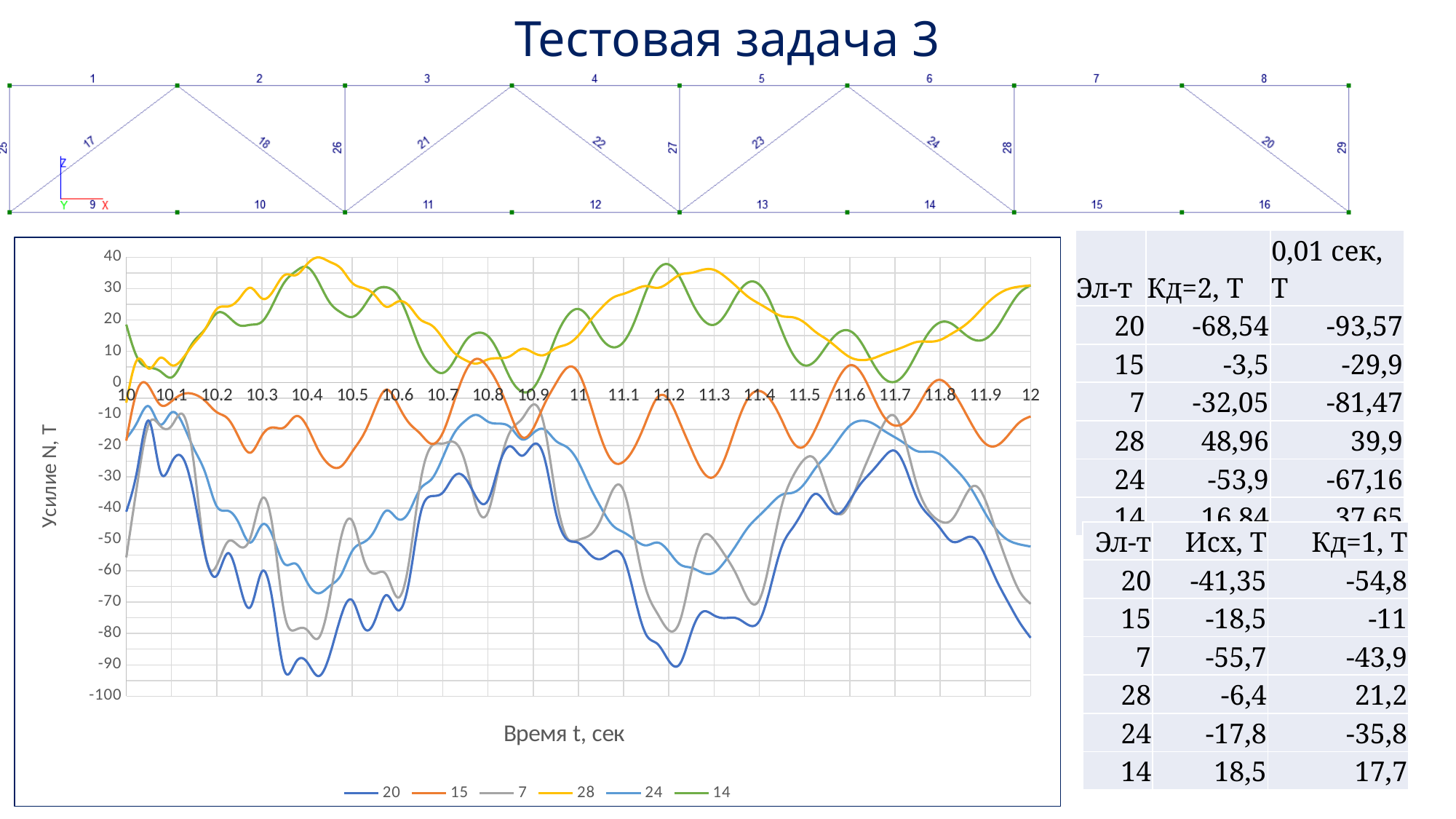
How many series does the chart legend list? 6 What kind of chart is shown on the slide? line chart At t = 11.2, which series has the larger value, 15 or 20? 15 Is the value of series 14 at t = 11.2 greater or less than 30? greater Does series 20 rise or fall between t = 11.7 and t = 12? fall At t = 10.4, which series has the larger value, 28 or 20? 28 Which series reaches the lowest value on the chart? 20 What is the title of the horizontal axis of the chart? Время t, сек What is the title of the vertical axis of the chart? Усилие N, Т Is the value of series 20 at t = 10.4 greater or less than -80? less Is the value of series 28 at t = 10.4 greater or less than 30? greater